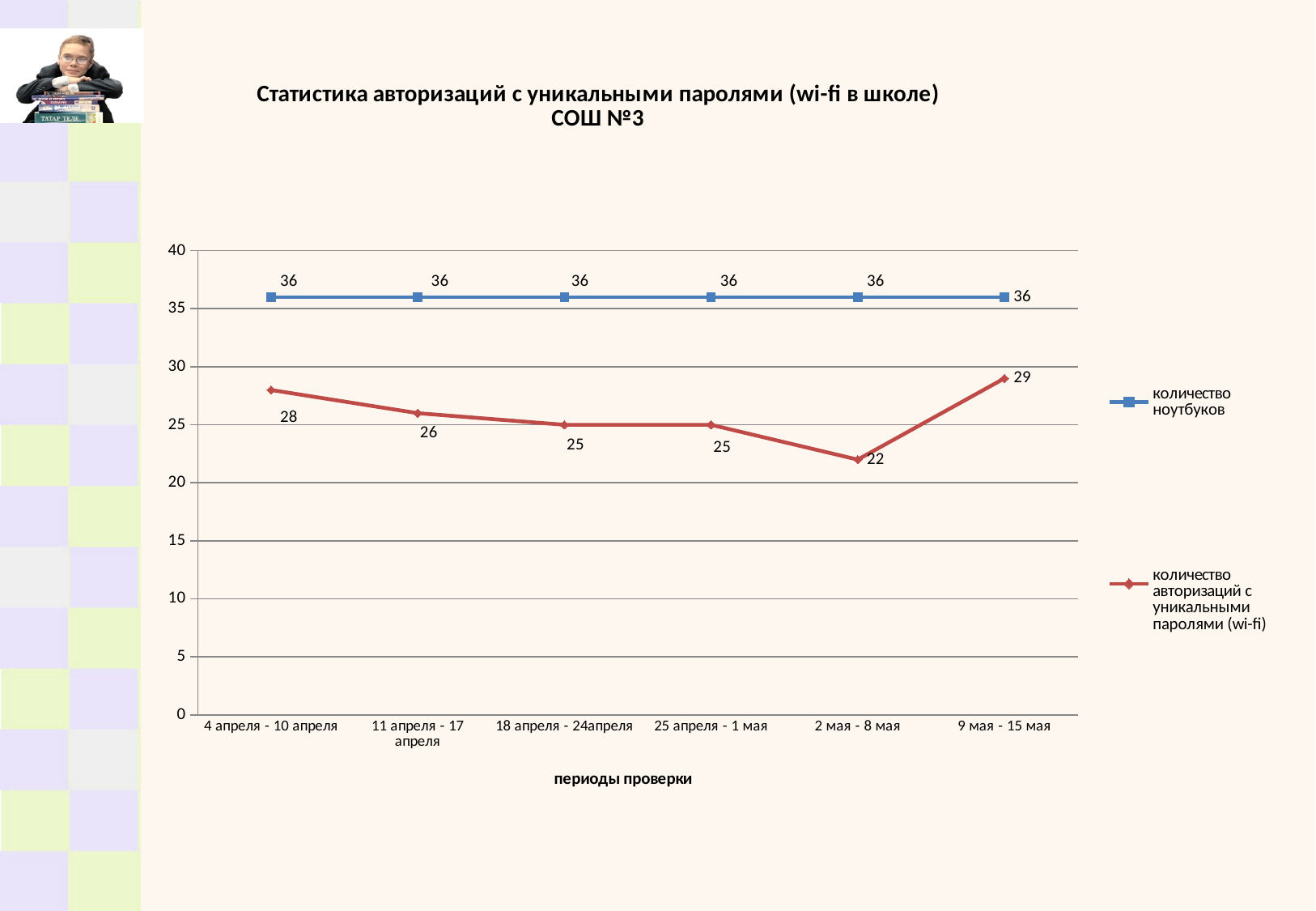
What is the number of authorizations with unique passwords (wi-fi) for the period 2 мая - 8 мая? 22 What is the number of laptops (количество ноутбуков) for the period 4 апреля - 10 апреля? 36 What kind of chart is shown on the slide? line chart Does the number of authorizations with unique passwords rise or fall from 4 апреля - 10 апреля to 2 мая - 8 мая? fall What is the difference between the number of laptops and the number of authorizations with unique passwords in the period 2 мая - 8 мая? 14 How many series does the legend list? 2 How many check periods are shown on the x axis? 6 Which is larger: the number of authorizations with unique passwords in 4 апреля - 10 апреля or in 11 апреля - 17 апреля? 4 апреля - 10 апреля What is the difference in authorizations with unique passwords between 9 мая - 15 мая and 2 мая - 8 мая? 7 In which period is the number of authorizations with unique passwords the lowest? 2 мая - 8 мая What is the number of authorizations with unique passwords for the period 9 мая - 15 мая? 29 In which period is the number of authorizations with unique passwords the highest? 9 мая - 15 мая